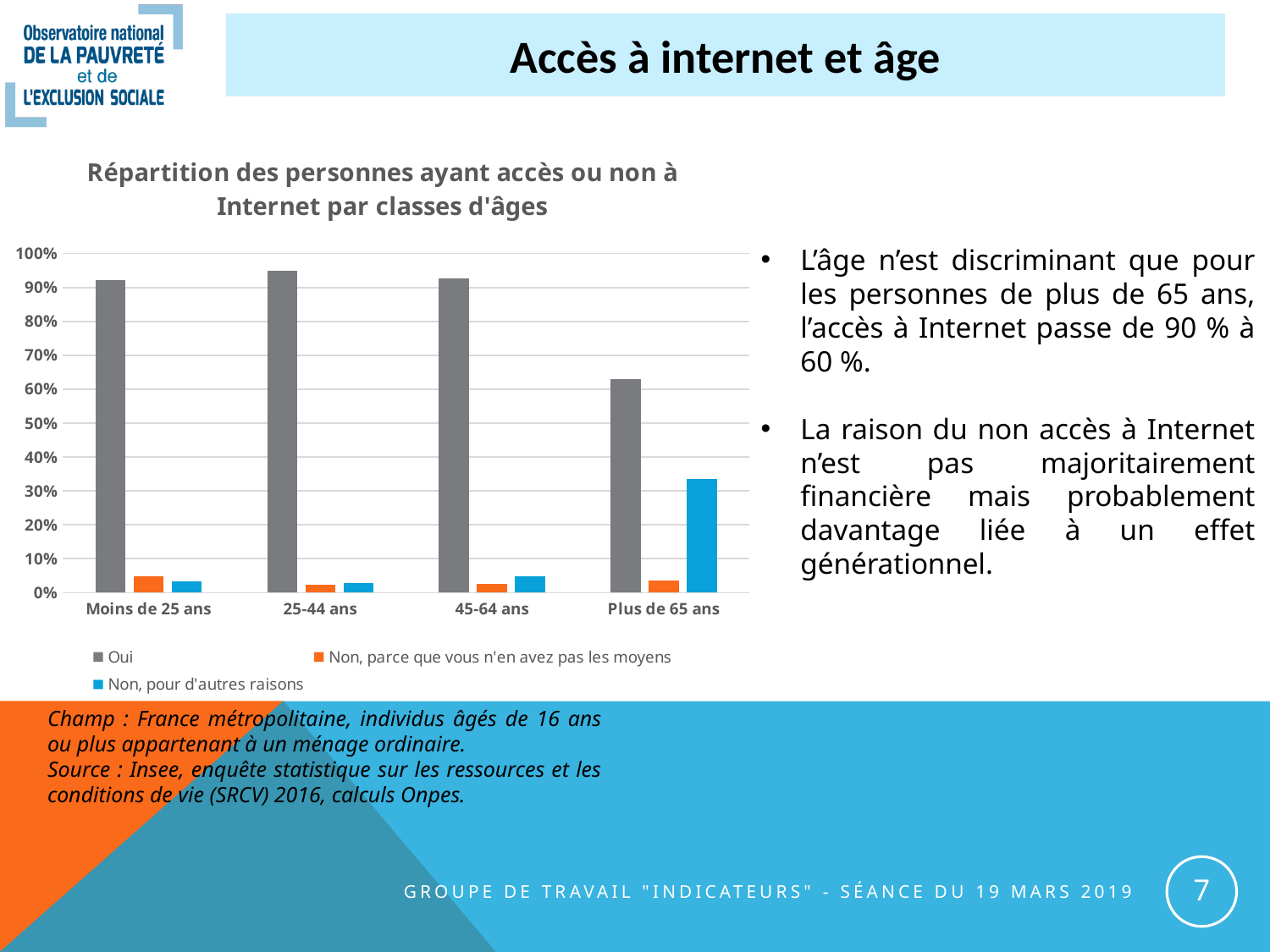
For 'Plus de 65 ans', which is larger: 'Non, pour d'autres raisons' or 'Non, parce que vous n'en avez pas les moyens'? Non, pour d'autres raisons Which age category has the lowest value for the 'Oui' series? Plus de 65 ans Which age category has the highest value for the 'Non, pour d'autres raisons' series? Plus de 65 ans Is the 'Non, pour d'autres raisons' value for 'Plus de 65 ans' greater or less than 30%? greater What kind of chart is shown on the slide? bar chart Is the 'Oui' value for 'Plus de 65 ans' greater or less than 70%? less How many age categories are shown on the x axis of the chart? 4 What is the title of the chart? Répartition des personnes ayant accès ou non à Internet par classes d'âges How many series does the chart's legend list? 3 Is the 'Oui' value for 'Moins de 25 ans' greater or less than 80%? greater Which is larger: the 'Oui' value for '25-44 ans' or the 'Oui' value for 'Plus de 65 ans'? 25-44 ans